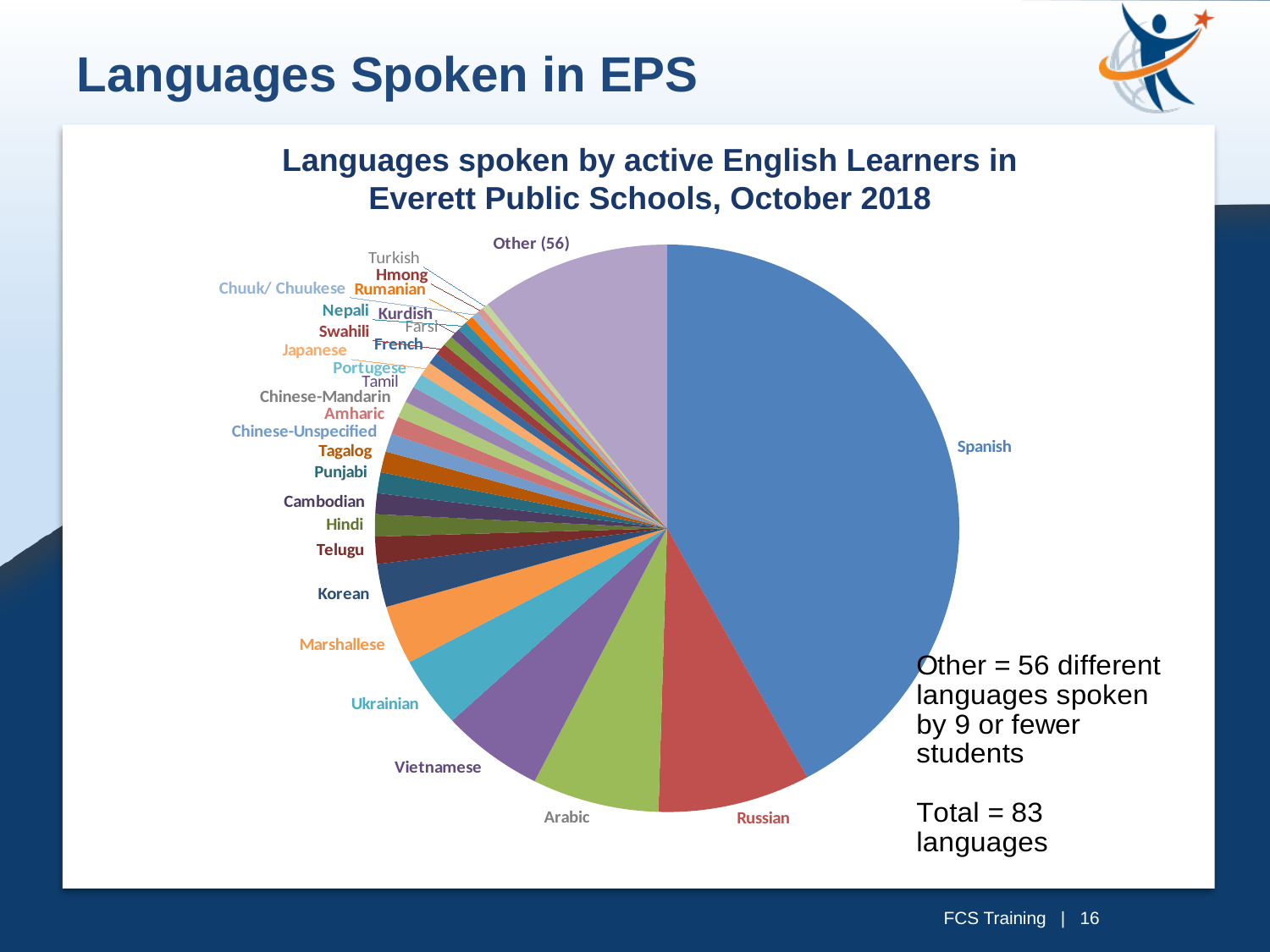
Which slice is larger, Spanish or Russian? Spanish Which slice is larger, Russian or Arabic? Russian Which slice is larger, Other (56) or Arabic? Other (56) According to the slide, how many languages are spoken in total? 83 What is the title of the chart? Languages spoken by active English Learners in Everett Public Schools, October 2018 What kind of chart is shown on the slide? pie chart Which language has the largest slice of the pie? Spanish How many different languages are grouped into the 'Other' slice? 56